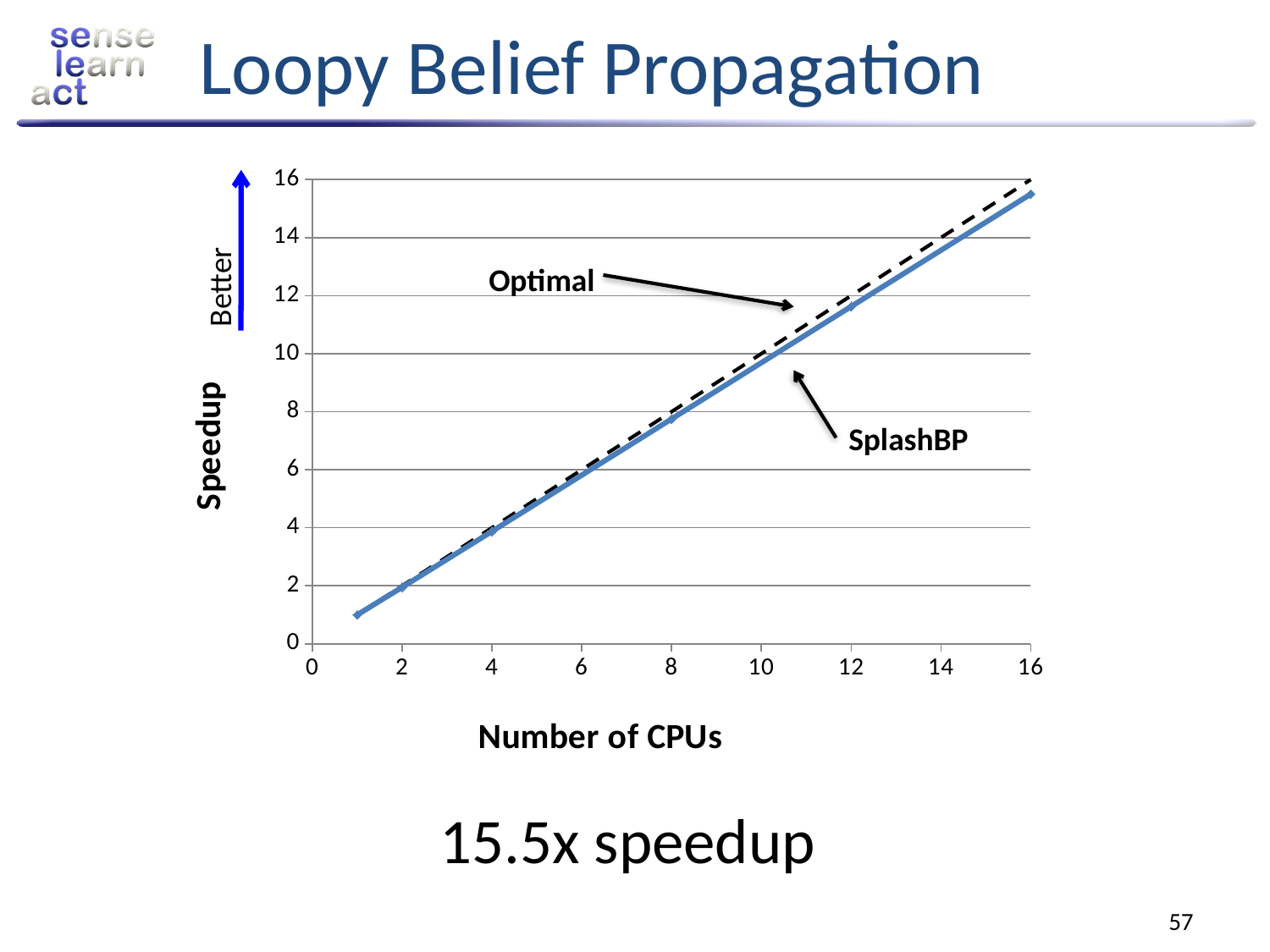
Is the SplashBP speedup at 12 CPUs greater or less than 10? greater Is the SplashBP speedup at 4 CPUs greater or less than 6? less Does the SplashBP speedup rise or fall as the number of CPUs increases? rise What kind of chart is shown on the slide? line chart Is the SplashBP speedup at 16 CPUs greater or less than 14? greater What is the label of the x axis? Number of CPUs Which line is higher at 16 CPUs, Optimal or SplashBP? Optimal What speedup does the slide state SplashBP achieves? 15.5x How many series are plotted on the chart? 2 What is the maximum value shown on the Speedup axis? 16 What are the names of the two lines plotted on the chart? Optimal and SplashBP